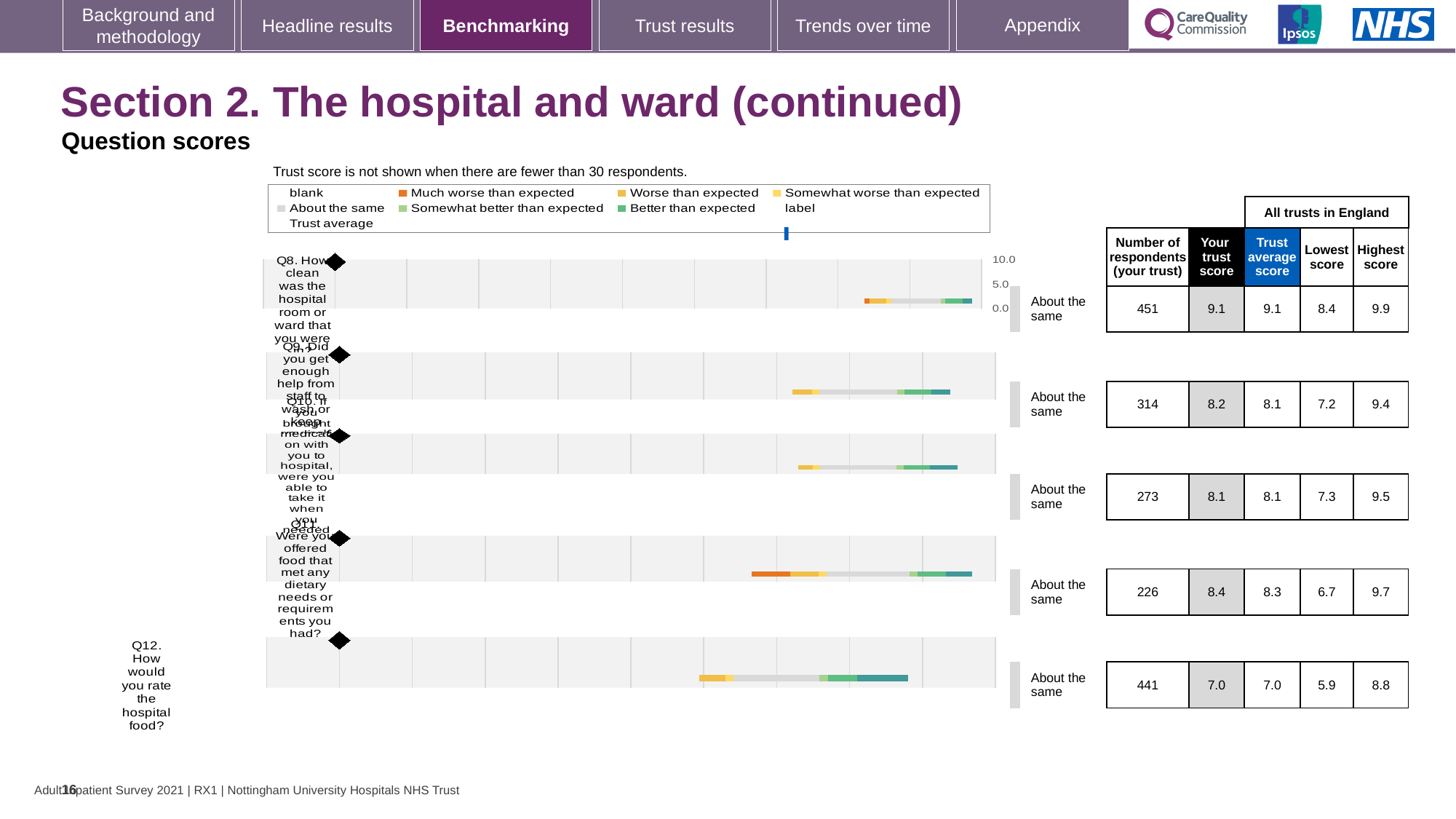
What type of chart is used to show the question scores on this slide? bar chart How many respondents answered Q11 for this trust? 226 What is the difference between the trust score for Q8 and the trust score for Q12? 2.1 What is the trust score for Q8 (how clean was the hospital room or ward)? 9.1 What is the trust score for Q12 (how would you rate the hospital food)? 7.0 What benchmark category is shown for Q12 in the question scores chart? About the same Which question has the highest trust score? Q8 Which has the larger trust score, Q9 or Q10? Q9 Which question has the lowest trust score? Q12 What is the highest score across all trusts in England for Q9? 9.4 What is the lowest score across all trusts in England for Q11? 6.7 How many questions (categories) are plotted in the question scores chart? 5